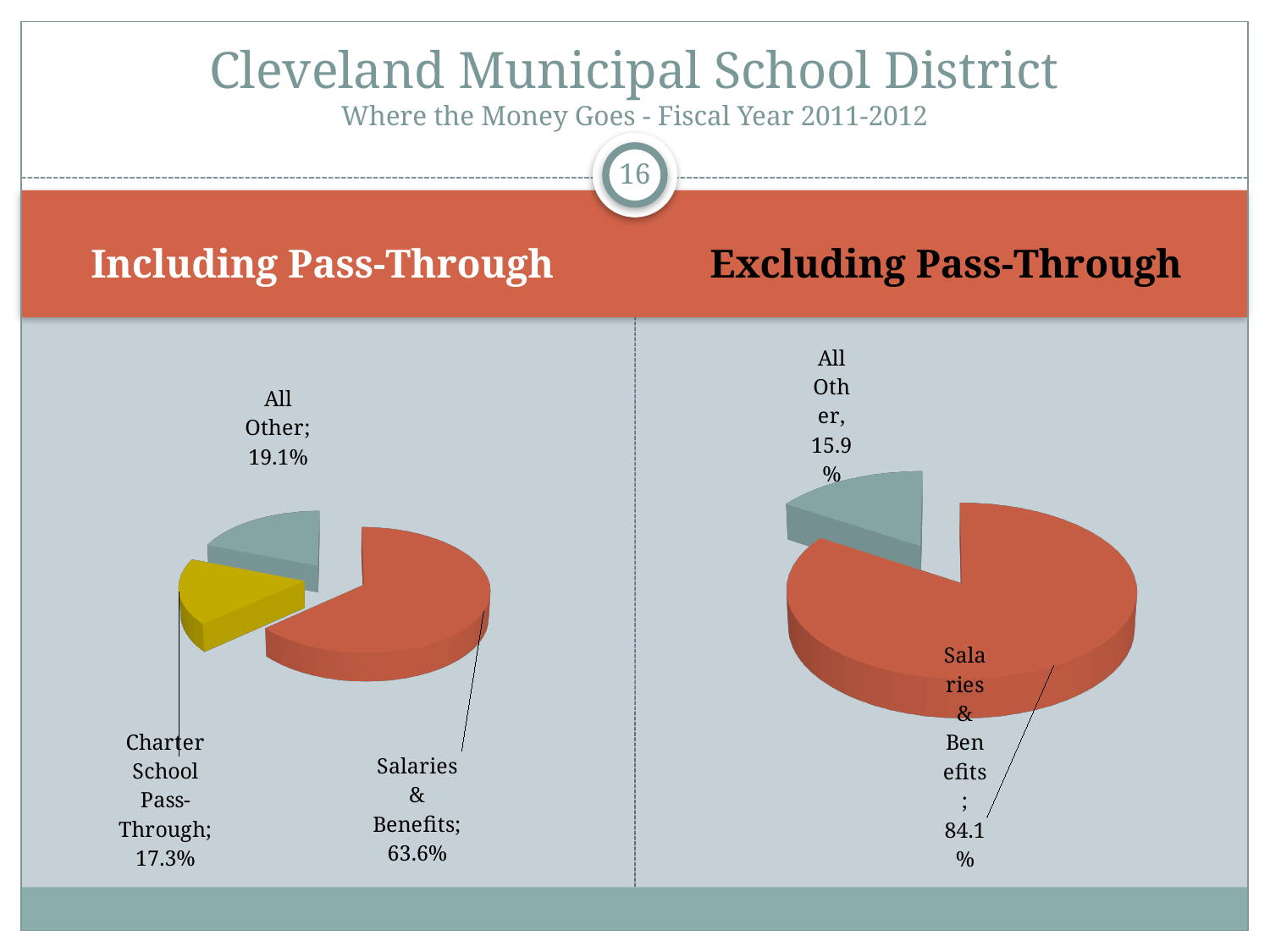
What type of chart is used on the Excluding Pass-Through side of the slide? Pie chart In the Including Pass-Through pie chart, what share is Salaries & Benefits? 63.6% In the Including Pass-Through pie chart, what share is All Other? 19.1% In the Excluding Pass-Through pie chart, which slice is the smallest? All Other In the Excluding Pass-Through pie chart, what is the difference between the Salaries & Benefits share and the All Other share? 68.2% In the Including Pass-Through pie chart, what is the difference between the Salaries & Benefits share and the All Other share? 44.5% In the Including Pass-Through pie chart, what share is Charter School Pass-Through? 17.3% How many slices does the Including Pass-Through pie chart have? 3 In the Including Pass-Through pie chart, which slice is the largest? Salaries & Benefits In the Including Pass-Through pie chart, which slice is the smallest? Charter School Pass-Through